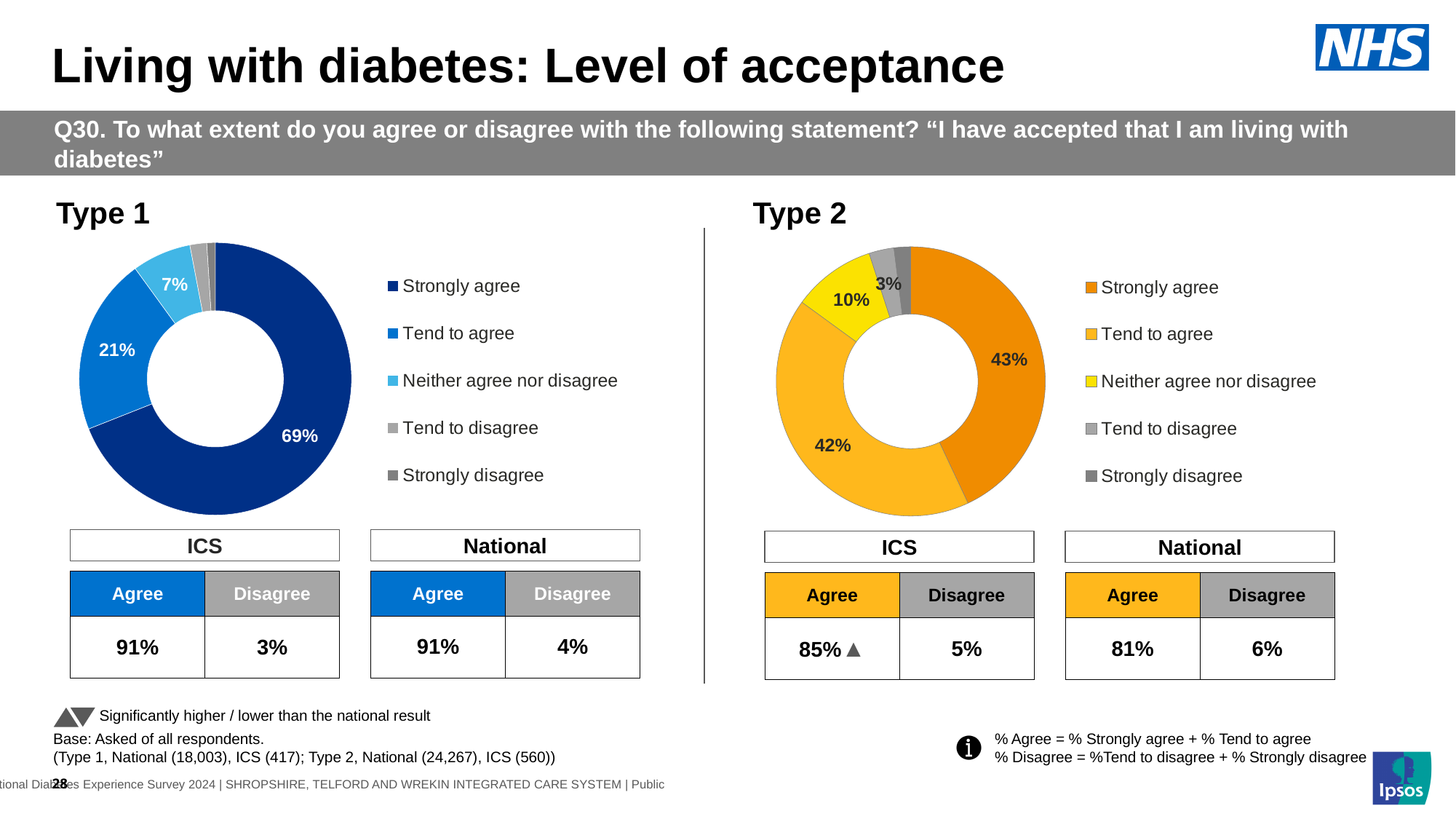
On the Type 2 chart, what percentage of respondents tend to agree? 42% On the Type 2 chart, which is larger: Neither agree nor disagree or Tend to disagree? Neither agree nor disagree On the Type 1 chart, what percentage of respondents tend to agree? 21% On the Type 1 chart, what is the difference in percentage points between Strongly agree and Tend to agree? 48 percentage points What kind of chart is used for Type 1? Donut (pie) chart How many response categories does the legend of the Type 2 chart list? 5 On the Type 2 chart, what colour represents Neither agree nor disagree? Yellow On the Type 2 chart, what percentage neither agree nor disagree? 10% On the Type 2 chart, what percentage of respondents strongly agree? 43% On the Type 1 chart, which response category has the largest share? Strongly agree On the Type 1 chart, what percentage of respondents strongly agree? 69% On the Type 1 chart, what percentage neither agree nor disagree? 7%